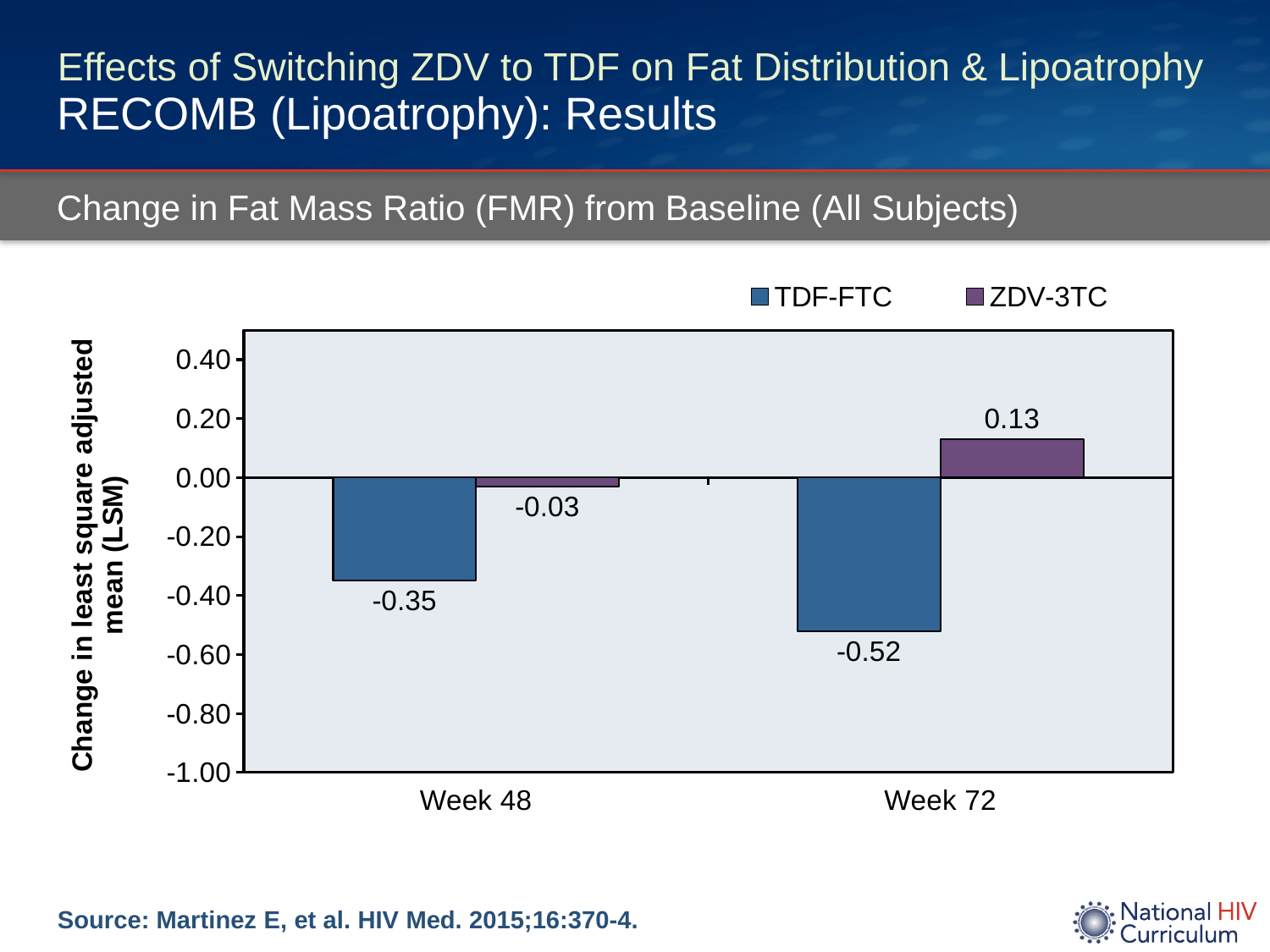
Which is larger at Week 48, the TDF-FTC value or the ZDV-3TC value? ZDV-3TC How many series does the legend list? 2 Which series has the lowest value on the chart? TDF-FTC How many categories are shown on the x axis? 2 Which series has the highest value on the chart? ZDV-3TC What kind of chart is shown on the slide? Bar chart What is the value for TDF-FTC at Week 48? -0.35 What is the value for TDF-FTC at Week 72? -0.52 What is the difference between the ZDV-3TC and TDF-FTC values at Week 72? 0.65 What is the value for ZDV-3TC at Week 72? 0.13 What is the value for ZDV-3TC at Week 48? -0.03 What is the difference between the ZDV-3TC and TDF-FTC values at Week 48? 0.32